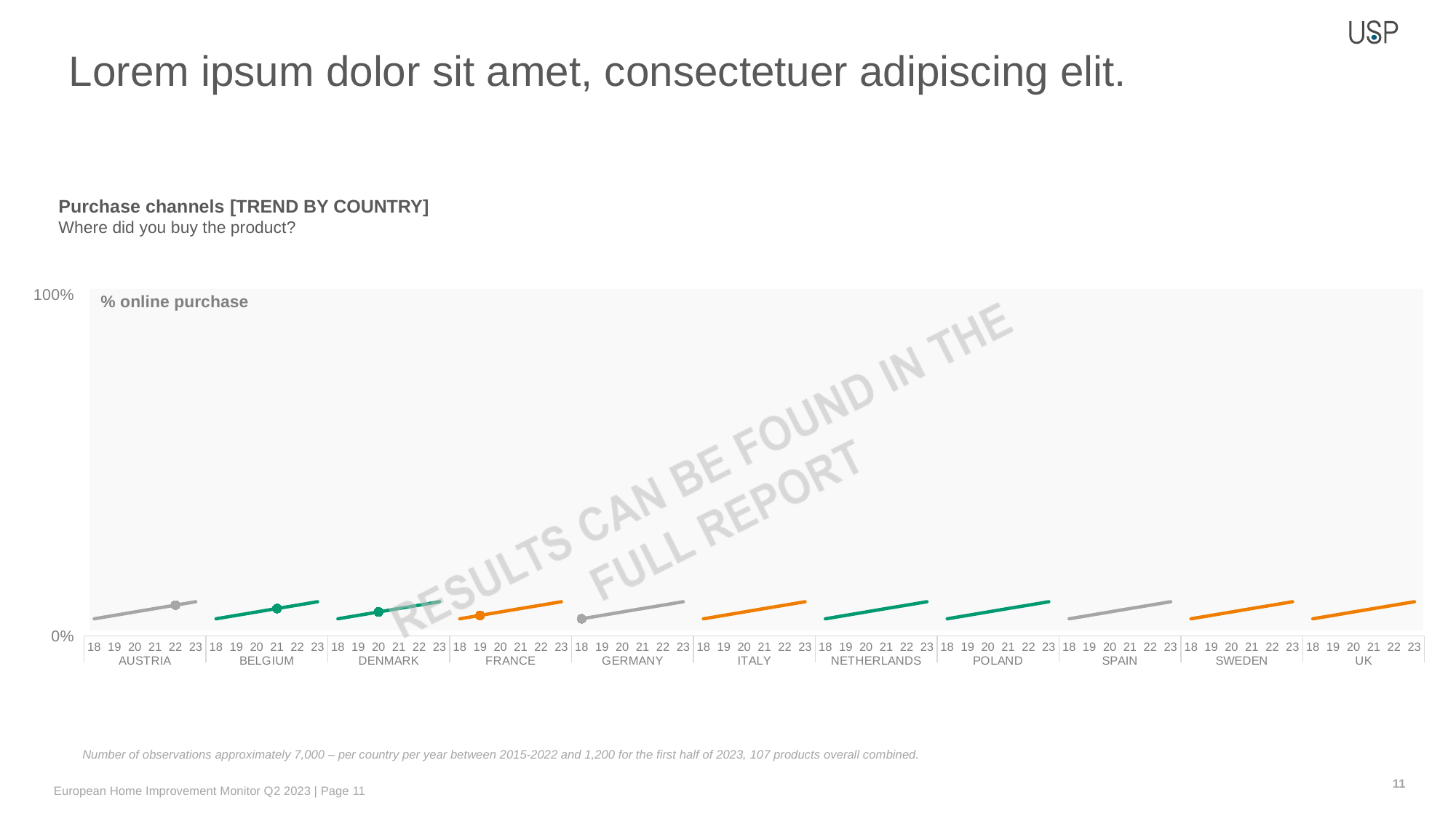
What measure does the chart plot, according to the label inside the plot area? % online purchase How many year points (18 to 23) are shown for each country on the x axis? 6 What is the highest value shown on the y axis of the chart? 100% Which country is listed first on the x axis of the chart? AUSTRIA Does the line for the UK rise or fall from 18 to 23? rise Is the value for Germany in 23 greater or less than 100%? less Does the line for Belgium rise or fall from 18 to 23? rise Does the line for Austria rise or fall from 18 to 23? rise Is the value for Spain in 18 greater or less than 100%? less How many countries are shown along the x axis of the chart? 11 What kind of chart is shown on the slide? line chart